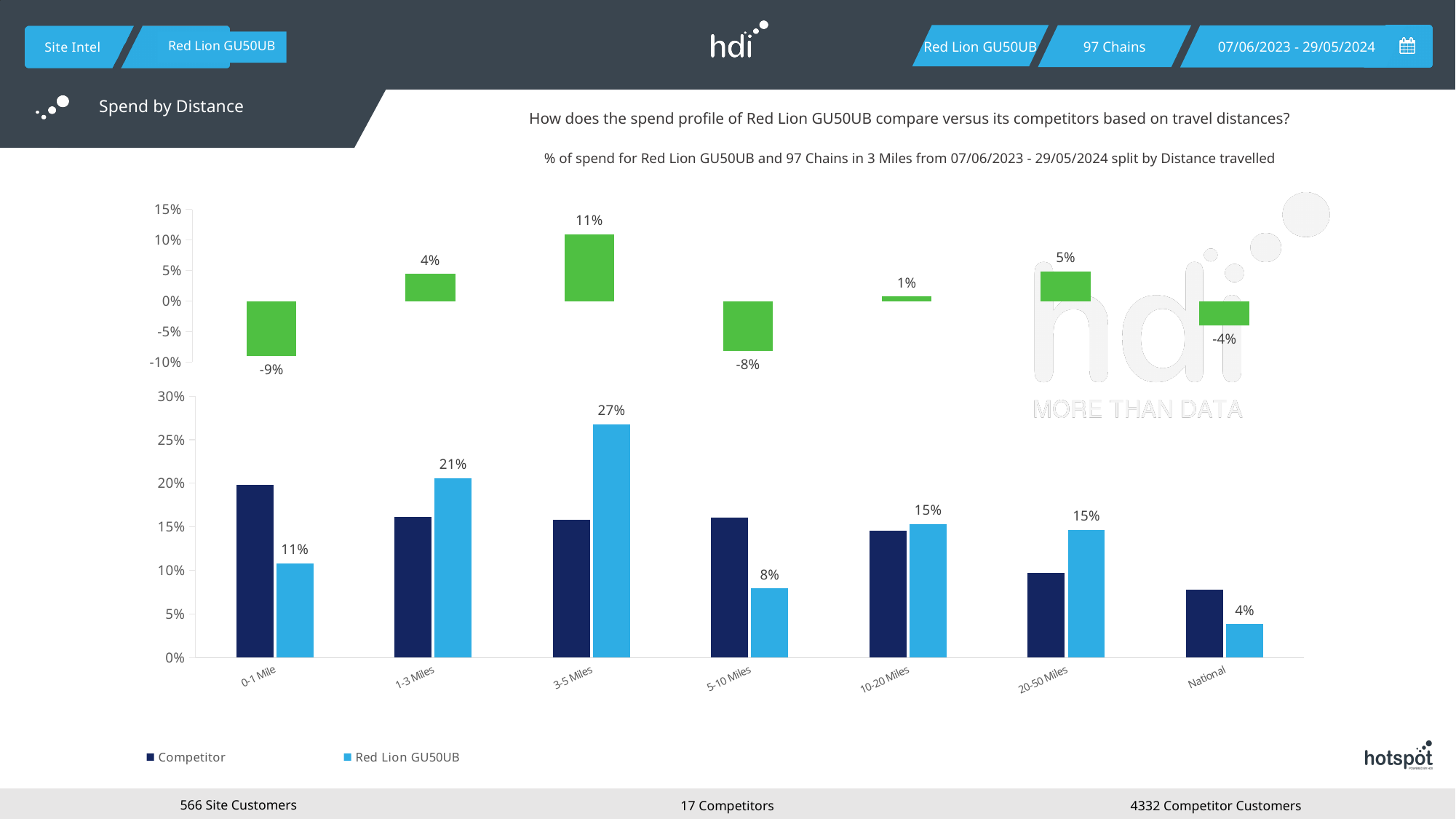
In the bottom chart, what is the difference between the Red Lion GU50UB values at 3-5 Miles and 5-10 Miles? 19% How many distance categories are shown on the x axis of the bottom chart? 7 In the bottom chart, is the Competitor value at 0-1 Mile greater or less than 15%? greater In the bottom chart, what is the value for Red Lion GU50UB at 3-5 Miles? 27% In the bottom chart, what is the value for Red Lion GU50UB at National? 4% In the top chart, which distance band has the highest value? 3-5 Miles In the bottom chart, which distance band has the lowest Red Lion GU50UB value? National In the bottom chart, at 0-1 Mile, which series has the larger value: Competitor or Red Lion GU50UB? Competitor In the top chart, what is the value shown for 0-1 Mile? -9% What type of chart is the bottom chart? Bar chart How many series does the legend of the bottom chart list? 2